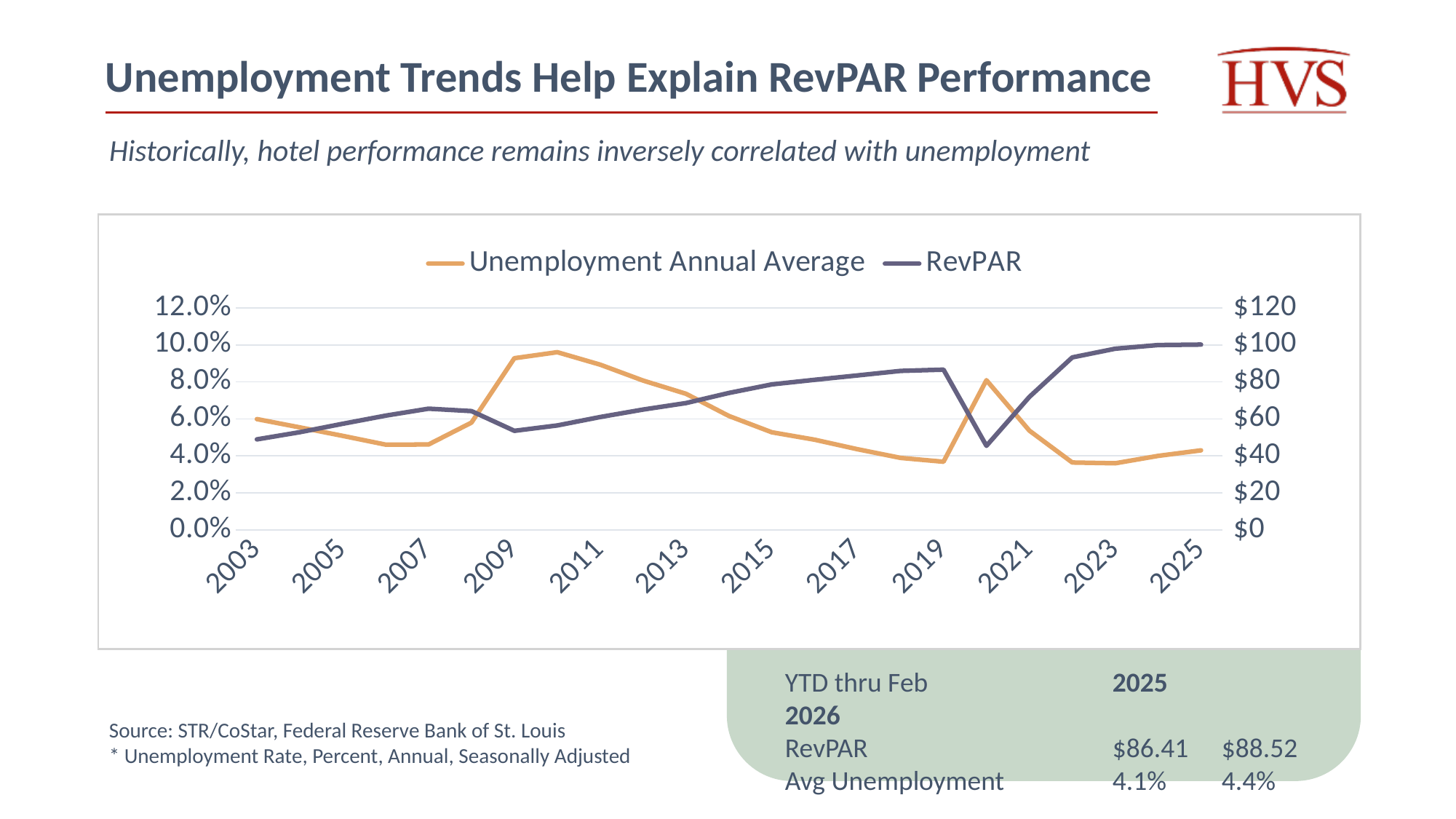
How many series does the chart's legend list? 2 What kind of chart is shown on the slide? line chart Is the RevPAR value for 2020 greater or less than $60? less Is the RevPAR value for 2025 greater or less than $80? greater What are the two series named in the chart's legend? Unemployment Annual Average and RevPAR Is the RevPAR value for 2003 greater or less than $60? less Does the RevPAR line rise or fall from 2020 to 2025? rise Which year has the higher RevPAR, 2019 or 2020? 2019 Which year has the higher Unemployment Annual Average, 2007 or 2009? 2009 Which series is plotted against the right-hand dollar axis? RevPAR